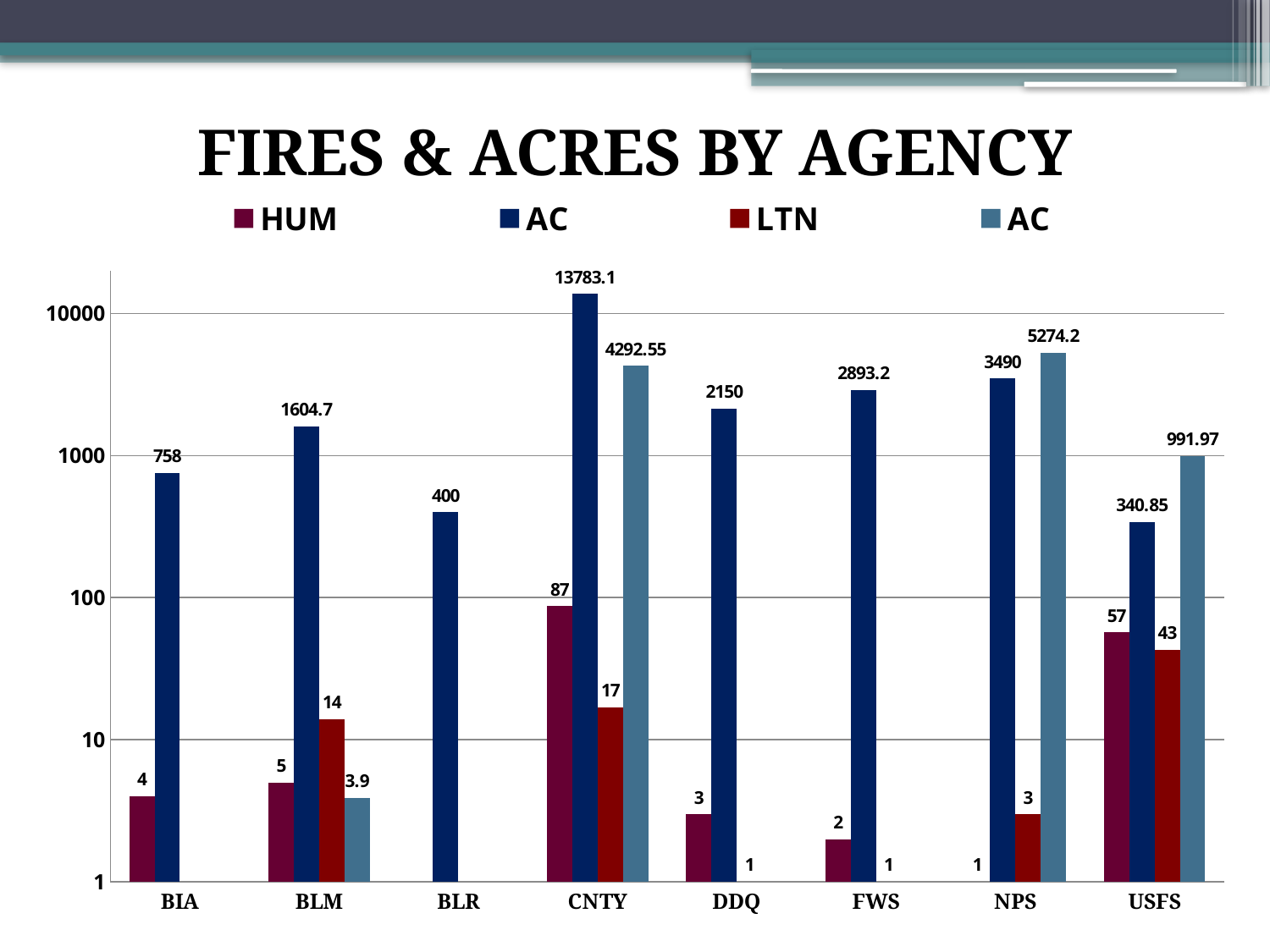
What is the LTN value for USFS? 43 How many series does the legend list? 4 What is the dark blue AC value for BLM? 1604.7 What is the HUM value for CNTY? 87 Which agency has the highest dark blue AC value? CNTY What is the light blue AC value for NPS? 5274.2 What is the difference between the HUM values for USFS and CNTY? 30 Which agency has the lowest dark blue AC value? USFS What is the title of the chart? FIRES & ACRES BY AGENCY How many agencies are shown along the x axis? 8 Which is larger, the LTN value for BLM or the LTN value for CNTY? CNTY What kind of chart is shown on the slide? bar chart